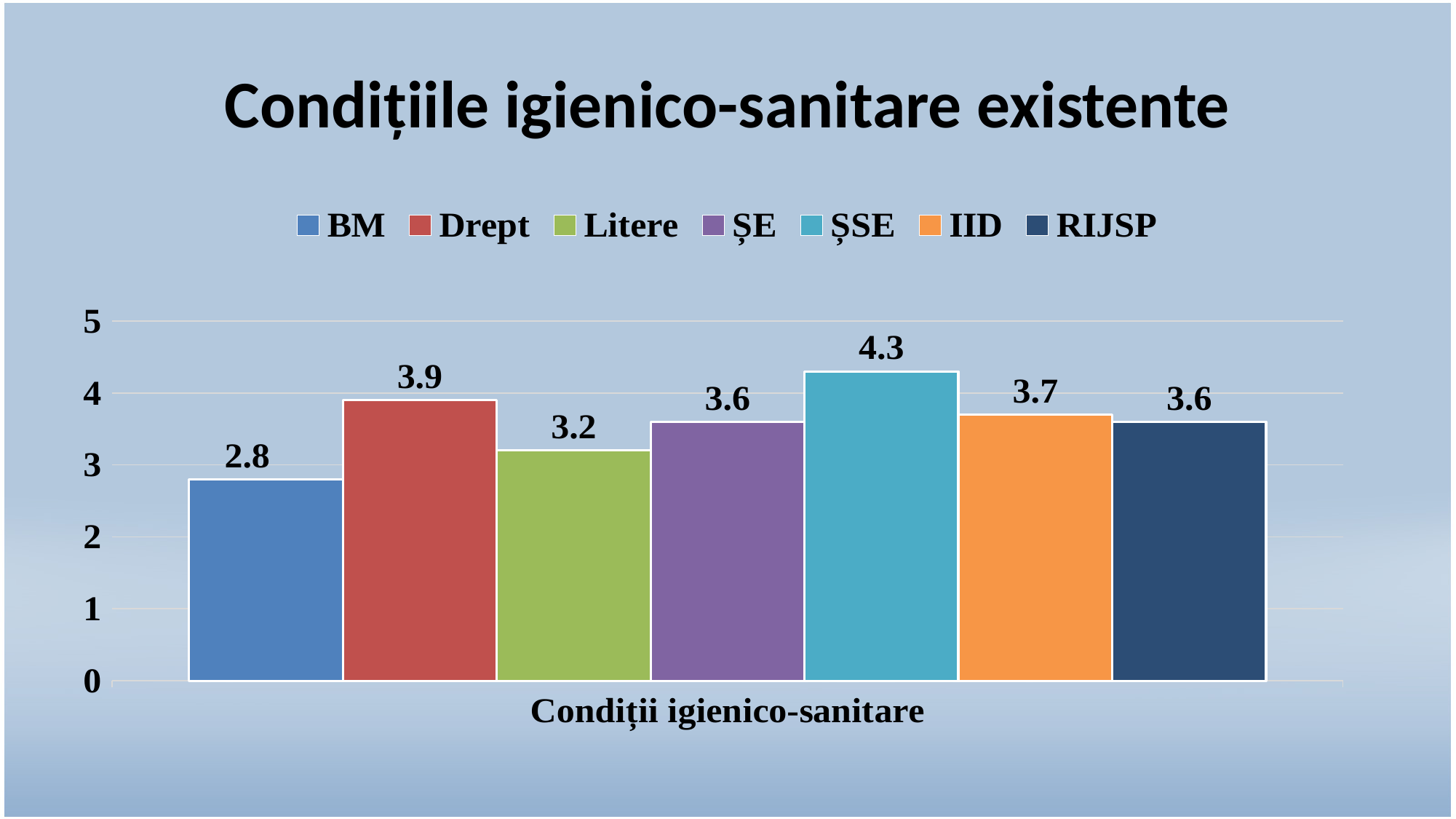
What is the difference between the values for ȘSE and BM? 1.5 Which is larger, the value for Drept or the value for IID? Drept Which series has the lowest value? BM What is the difference between the values for Drept and Litere? 0.7 What is the title of the chart? Condițiile igienico-sanitare existente What kind of chart is shown on the slide? bar chart What is the value for Litere? 3.2 Which series has the highest value? ȘSE What is the value for BM? 2.8 Is the value for BM greater or less than 3? less How many series does the legend list? 7 What is the value for ȘSE? 4.3